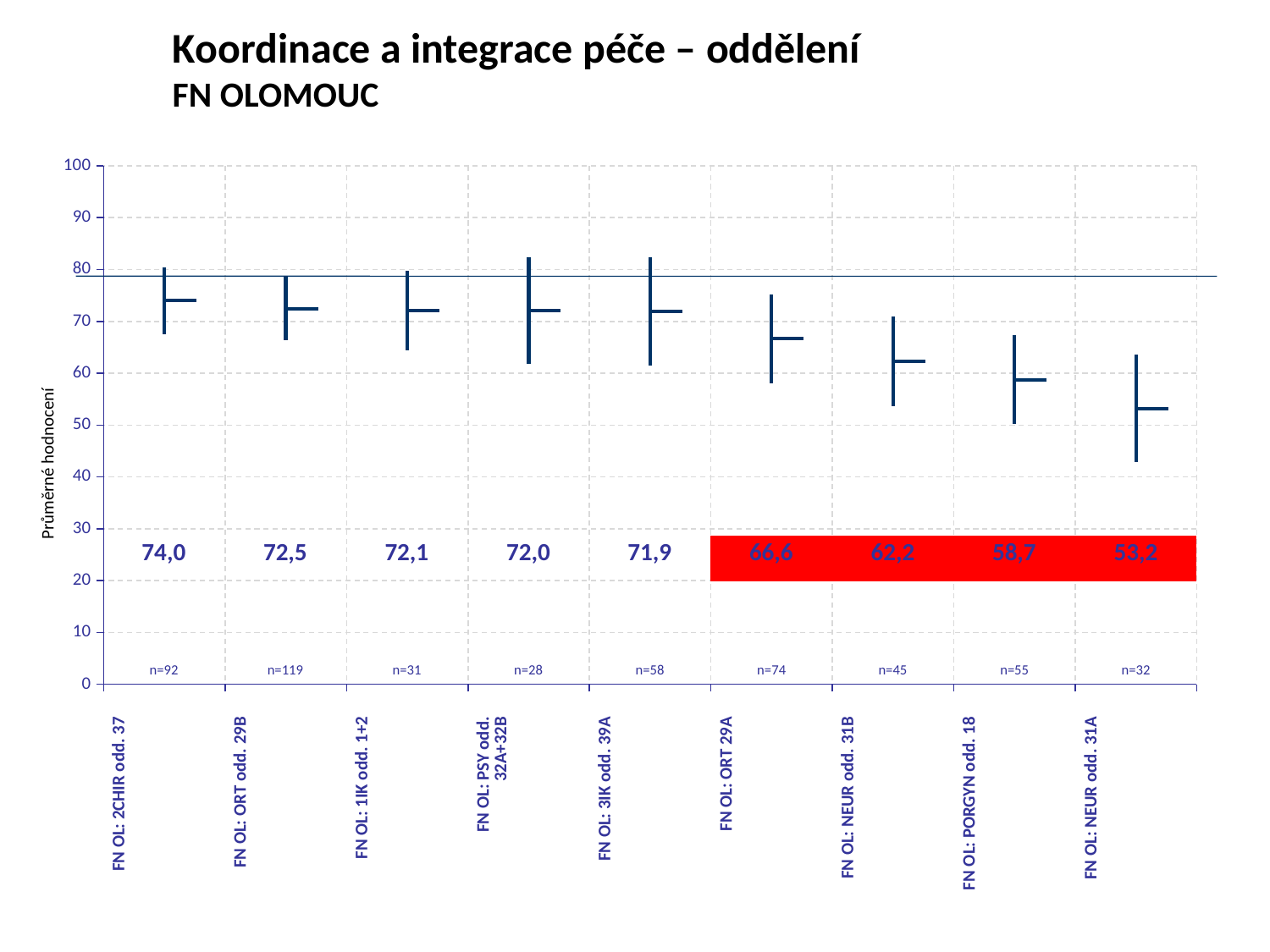
What is the average rating for FN OL: NEUR odd. 31A? 53,2 What is the label of the y axis? Průměrné hodnocení Which has a higher average rating, FN OL: NEUR odd. 31B or FN OL: PORGYN odd. 18? FN OL: NEUR odd. 31B Do the average ratings rise or fall from left to right along the x axis? fall What is the sample size (n) for FN OL: ORT odd. 29B? n=119 Which department has the highest average rating? FN OL: 2CHIR odd. 37 What is the difference between the average ratings of FN OL: 2CHIR odd. 37 and FN OL: NEUR odd. 31A? 20,8 Which department has the lowest average rating? FN OL: NEUR odd. 31A How many departments are highlighted with a red background? 4 How many departments are shown on the chart? 9 What is the average rating for FN OL: 2CHIR odd. 37? 74,0 What is the average rating for FN OL: ORT 29A? 66,6